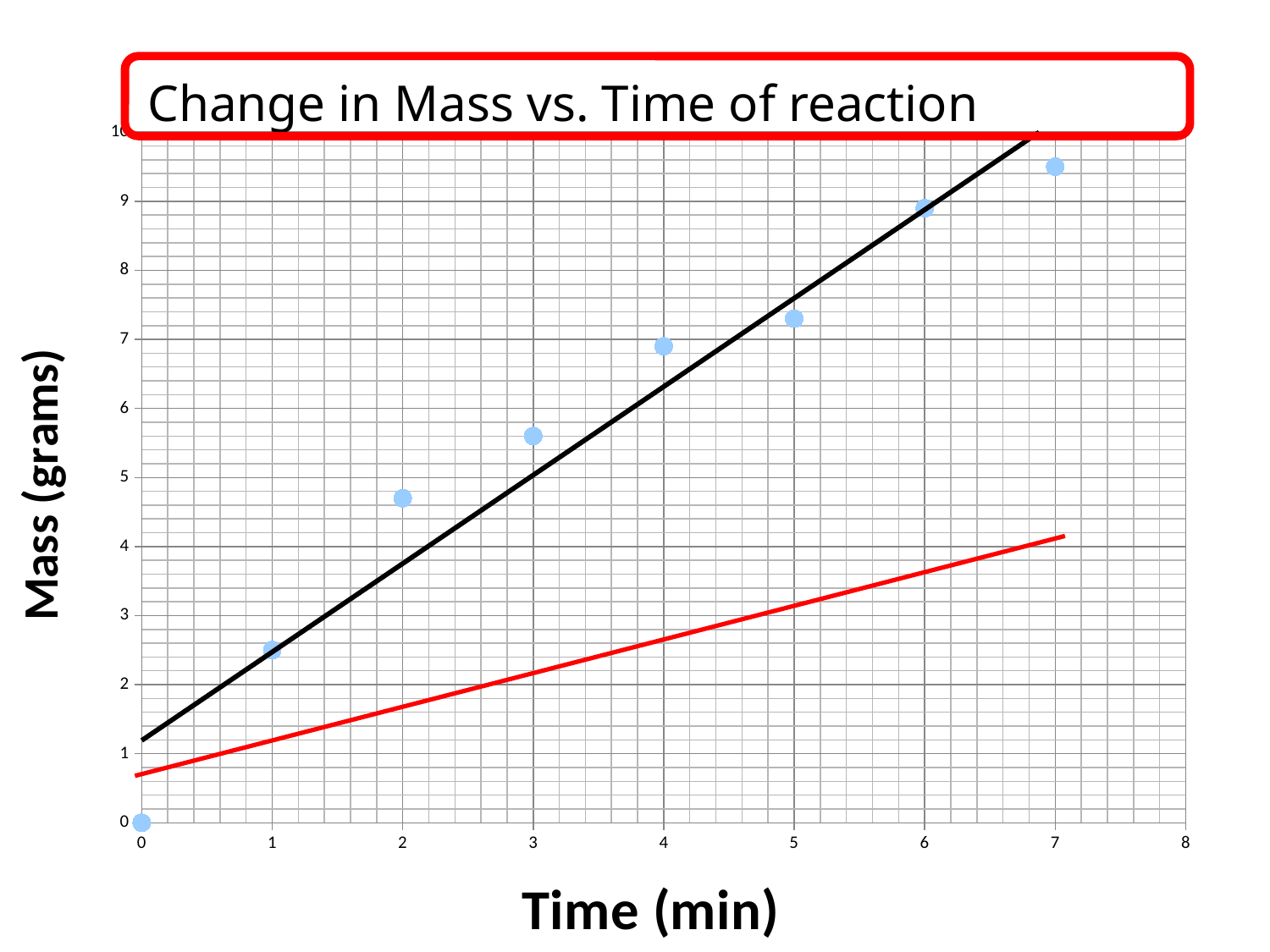
Do the plotted mass values rise or fall as time increases? rise Is the mass value at 3 min greater or less than 6? less Is the mass value at 1 min greater or less than 2? greater At which time is the plotted mass highest? 7 Is the mass value at 5 min greater or less than 8? less What is the title of the chart? Change in Mass vs. Time of reaction How many data points are plotted on the chart? 8 Which has the larger mass value, the point at 6 min or the point at 3 min? 6 min What is the label of the y axis? Mass (grams) At which time is the plotted mass lowest? 0 What is the mass value at time 0 min? 0 What kind of chart is shown on the slide? scatter chart